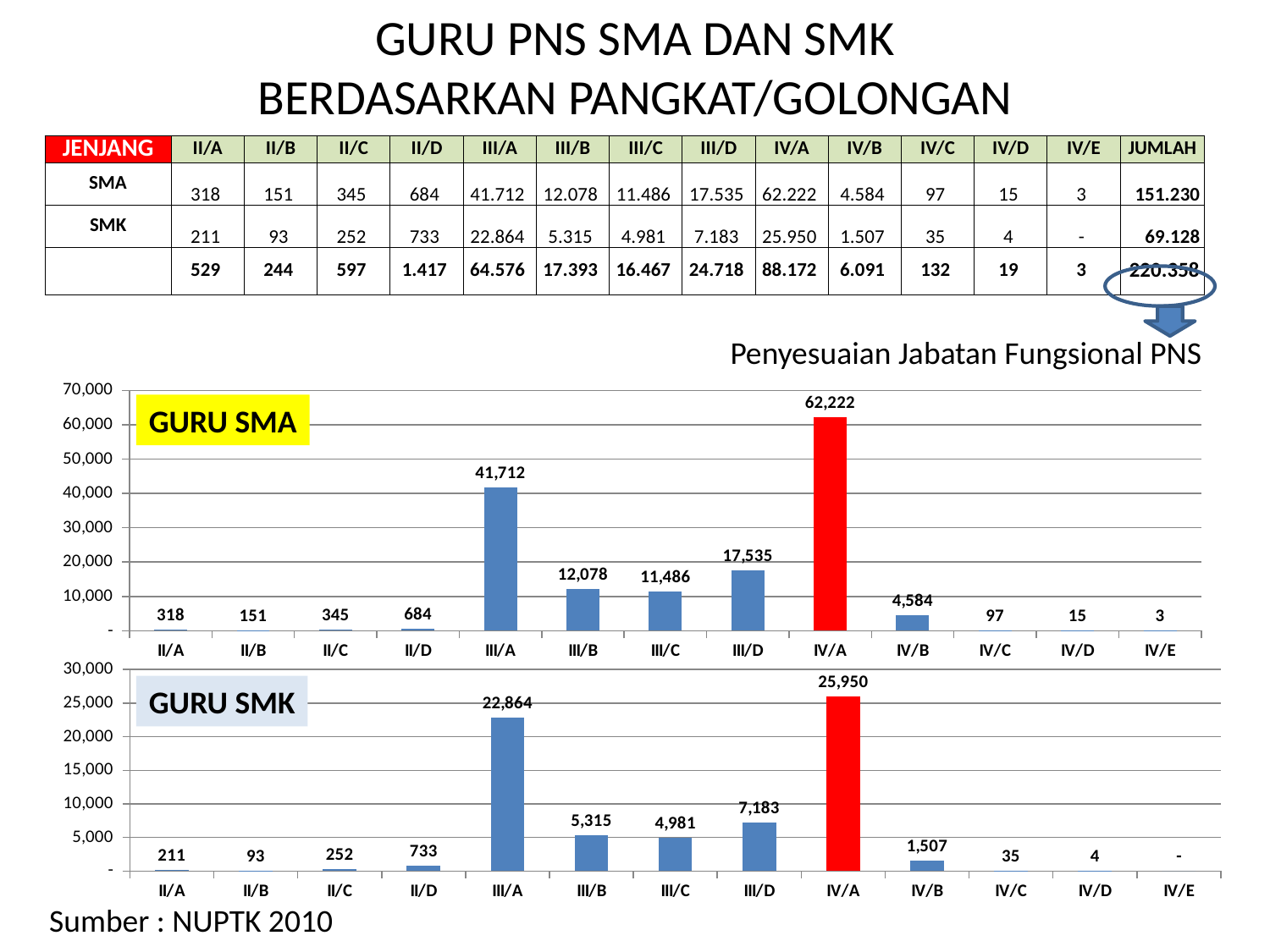
In the GURU SMK chart, what is the difference between the values for IV/A and III/A? 3,086 In the GURU SMK chart, what is the value for IV/B? 1,507 How many categories are shown on the x axis of the GURU SMK chart? 13 In the GURU SMA chart, what colour is the bar for IV/A? red What kind of chart is the GURU SMA chart? bar chart In the GURU SMK chart, which is larger, the value for III/B or the value for III/C? III/B In the GURU SMA chart, which category has the highest value? IV/A In the GURU SMA chart, is the value for III/A greater or less than 40,000? greater In the GURU SMA chart, what is the difference between the values for III/A and III/D? 24,177 In the GURU SMK chart, what is the value for III/A? 22,864 In the GURU SMK chart, which category has the lowest value? IV/E In the GURU SMA chart, what is the value for IV/A? 62,222